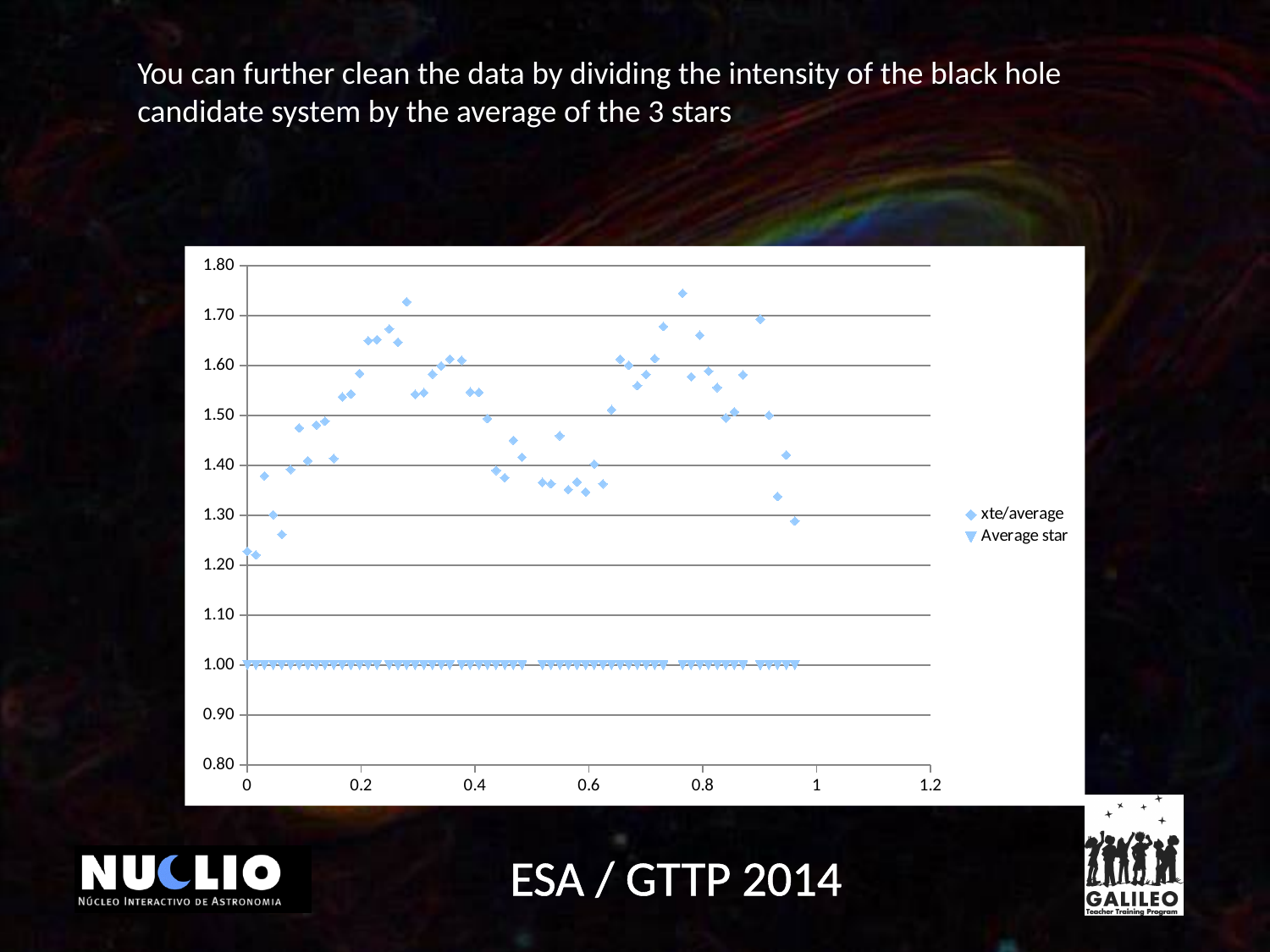
What kind of chart is shown on the slide? scatter chart Which series is plotted with triangle markers? Average star Are the Average star values greater or less than 1.10? less Is the xte/average value at x = 0.28 greater or less than 1.70? greater Which series has the higher values overall, xte/average or Average star? xte/average Do the Average star values rise, fall, or stay flat along the x axis? stay flat Is the xte/average value at x = 0 greater or less than 1.30? less What are the two series named in the legend? xte/average and Average star How many series does the legend list? 2